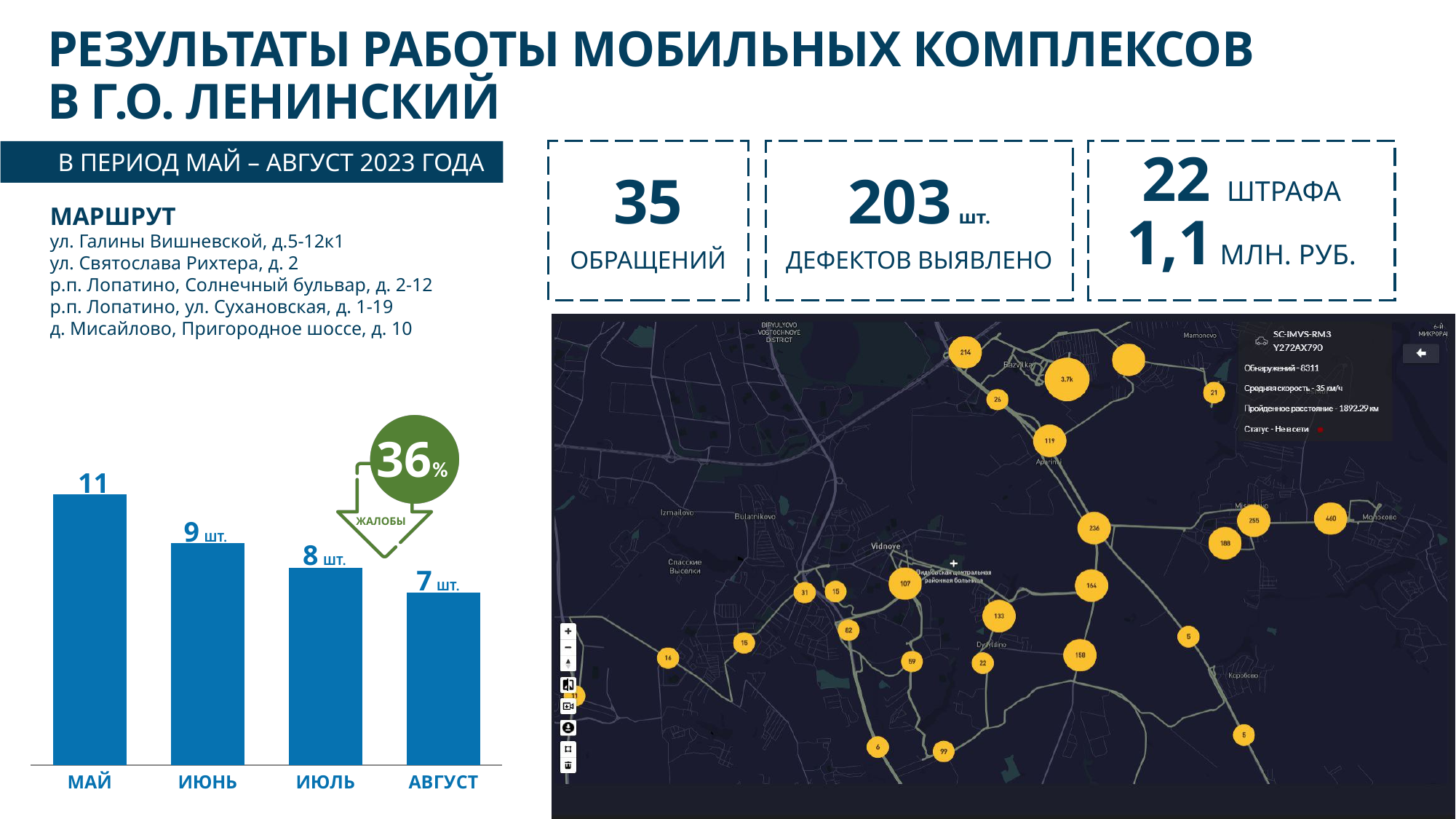
How many months (categories) are shown in the bar chart? 4 In the bar chart, what is the value for МАЙ? 11 In the bar chart, which is larger: the value for ИЮНЬ or the value for ИЮЛЬ? ИЮНЬ In the bar chart, what is the difference between the values for МАЙ and АВГУСТ? 4 In the bar chart, what is the value for АВГУСТ? 7 шт. In the bar chart, which month has the lowest value? АВГУСТ What percentage decrease in complaints (ЖАЛОБЫ) is shown in the green circle next to the bar chart? 36% In the bar chart, what is the value for ИЮЛЬ? 8 шт. Do the values in the bar chart rise or fall from МАЙ to АВГУСТ? fall What type of chart is shown on the left of the slide? bar chart In the bar chart, what is the value for ИЮНЬ? 9 шт. In the bar chart, which month has the highest value? МАЙ